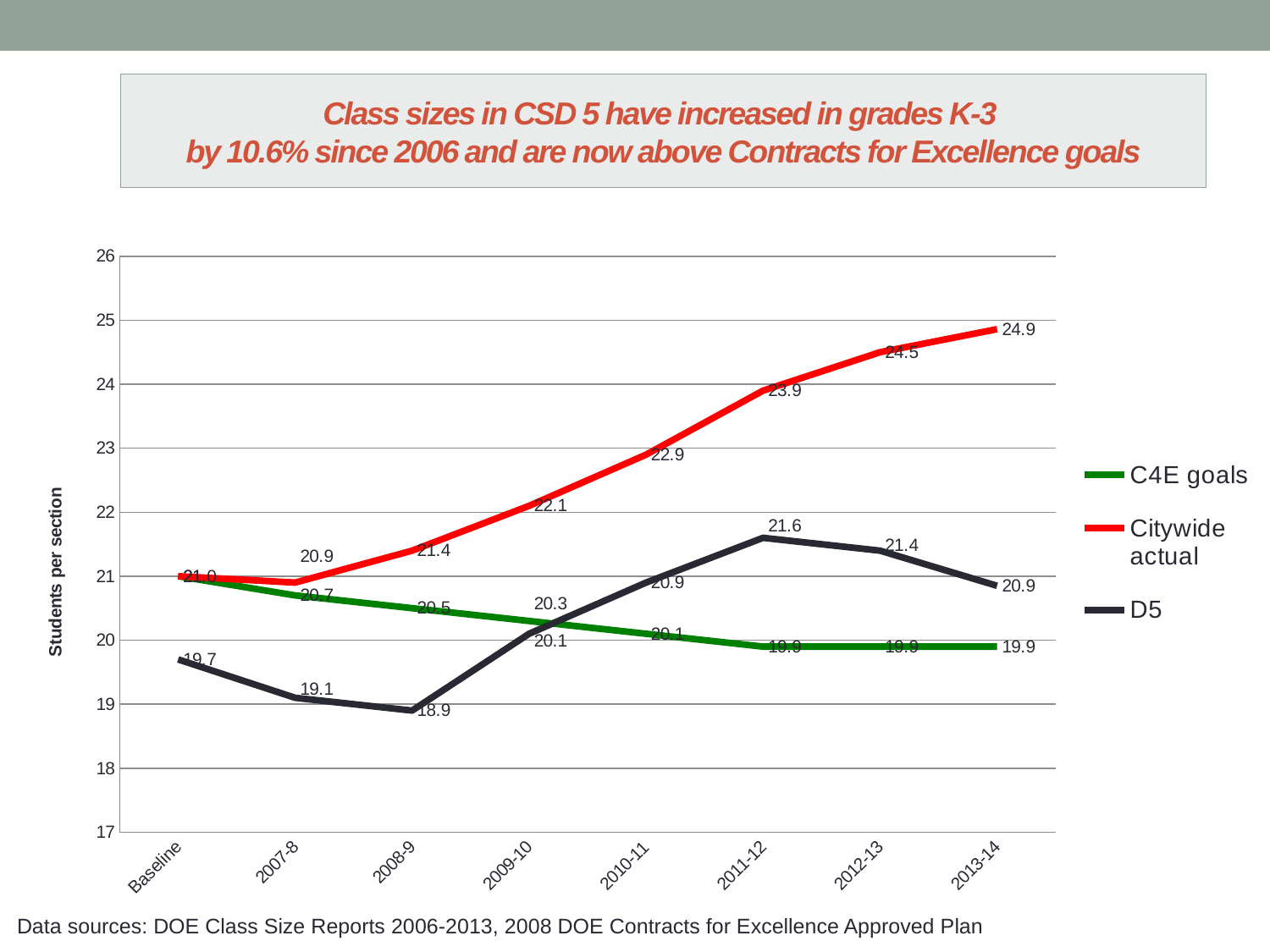
What is the label on the y axis? Students per section How many points are plotted along the x axis for each series? 8 What is the Citywide actual value for 2013-14? 24.9 What is the D5 value for 2007-8? 19.1 In which year is the Citywide actual series at its highest? 2013-14 Does the Citywide actual series rise or fall from 2008-9 to 2013-14? Rise What is the D5 value for 2011-12? 21.6 What is the difference between the Citywide actual value and the D5 value in 2013-14? 4.0 What kind of chart is shown on the slide? Line chart How many series does the legend list? 3 In which year is the D5 series at its lowest? 2008-9 Which is larger, the D5 value in 2011-12 or in 2012-13? 2011-12